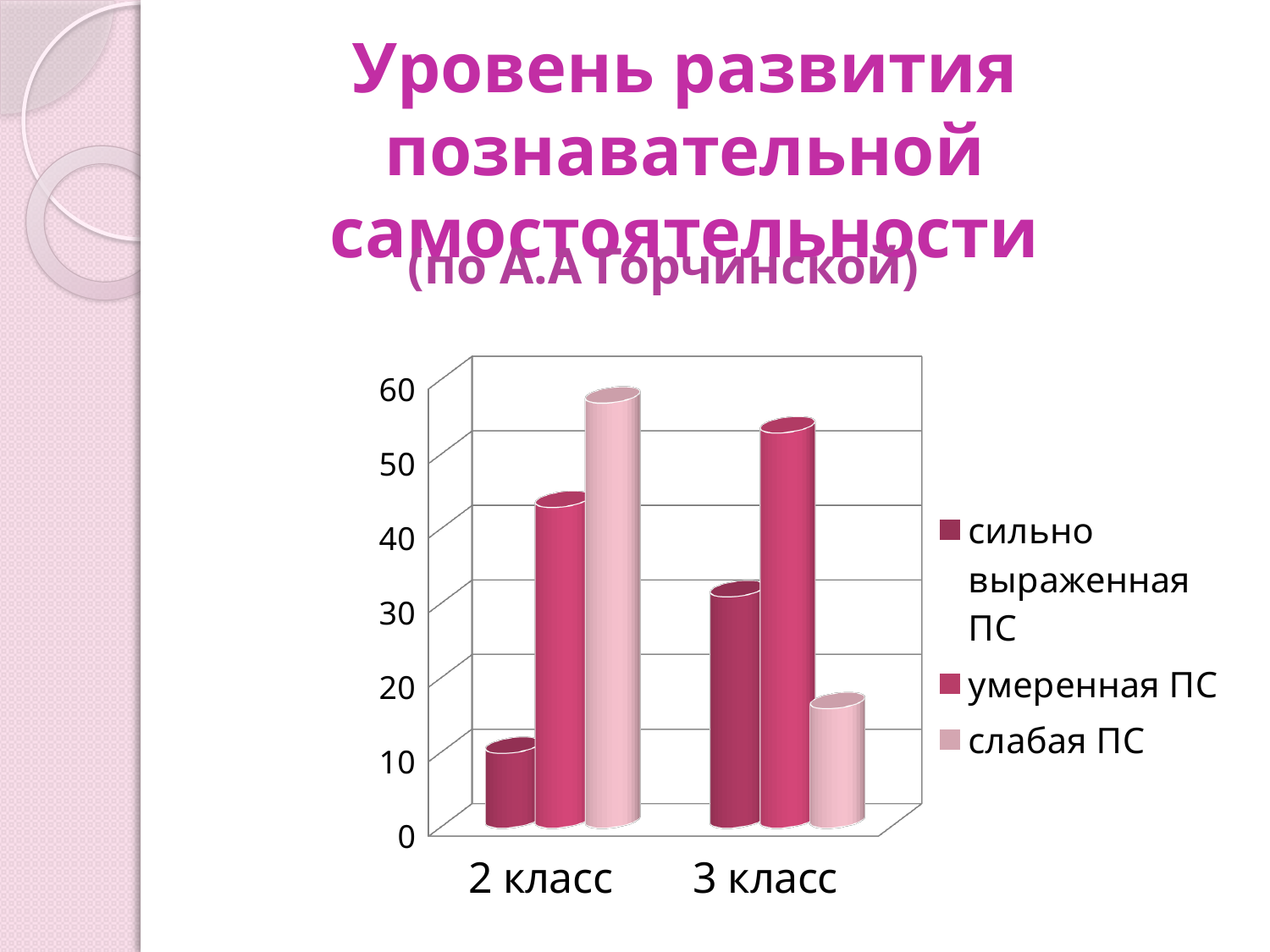
How many series does the legend list? 3 Is the value for умеренная ПС in 3 класс greater or less than 40? greater Which series has the highest value for 2 класс? слабая ПС Does the value for слабая ПС rise or fall from 2 класс to 3 класс? fall Which is larger: сильно выраженная ПС for 2 класс or for 3 класс? 3 класс What kind of chart is shown on the slide? bar chart How many categories are shown on the x axis? 2 Which series has the lowest value for 3 класс? слабая ПС Which series has the highest value for 3 класс? умеренная ПС Which series has the lowest value for 2 класс? сильно выраженная ПС Is the value for слабая ПС in 3 класс greater or less than 20? less Is the value for слабая ПС in 2 класс greater or less than 50? greater